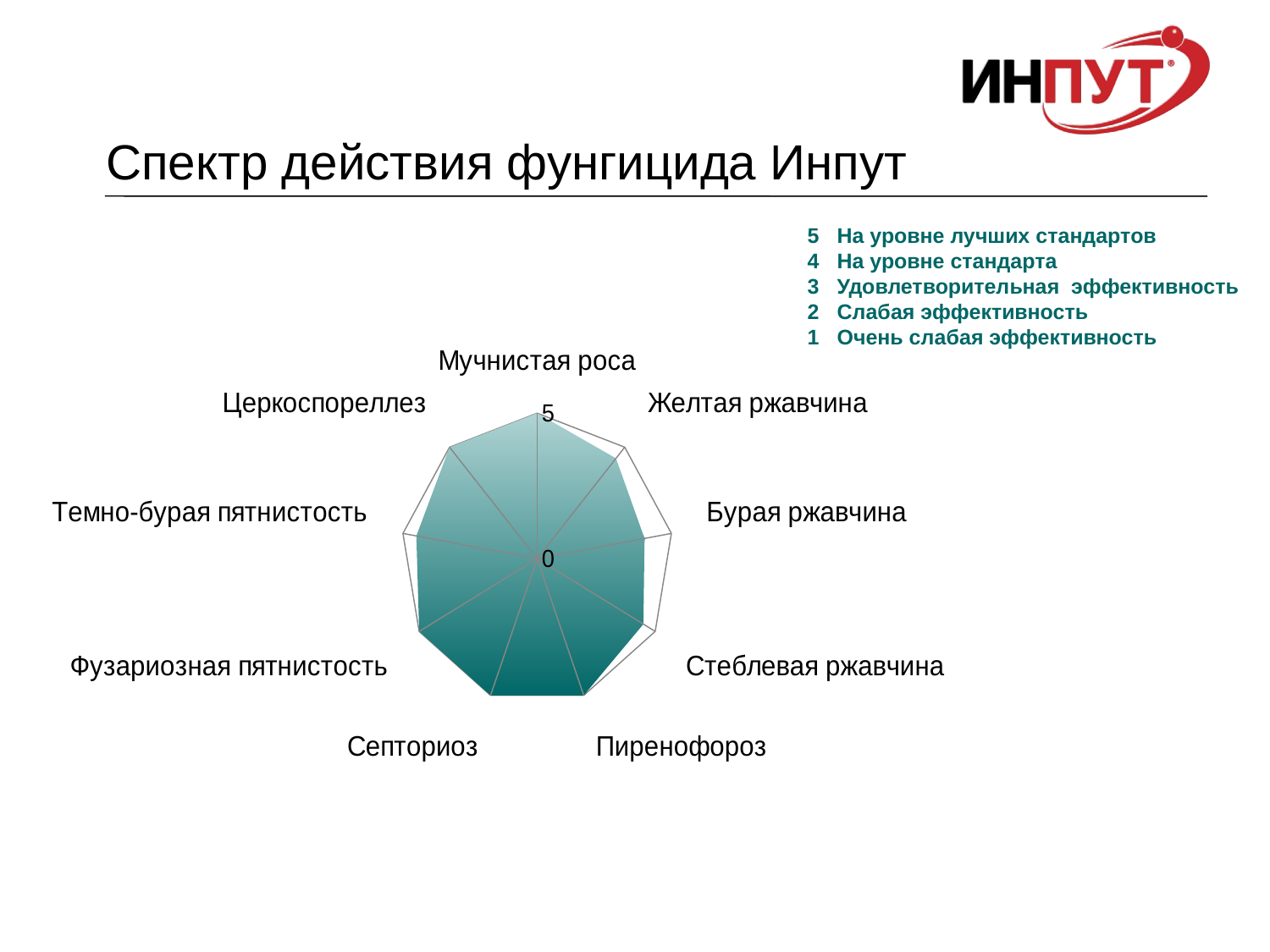
What kind of chart is shown on the slide? Radar chart How many disease categories are plotted on the radar chart? 9 What is the maximum value shown on the radar chart's axis? 5 What is the title of the slide containing the chart? Спектр действия фунгицида Инпут Is the value for Бурая ржавчина greater or less than 5? less Is the value for Септориоз greater or less than 0? greater Which is larger, the value for Мучнистая роса or the value for Стеблевая ржавчина? Мучнистая роса What is the value for Мучнистая роса on the radar chart? 5 Is the value for Желтая ржавчина greater or less than 5? less